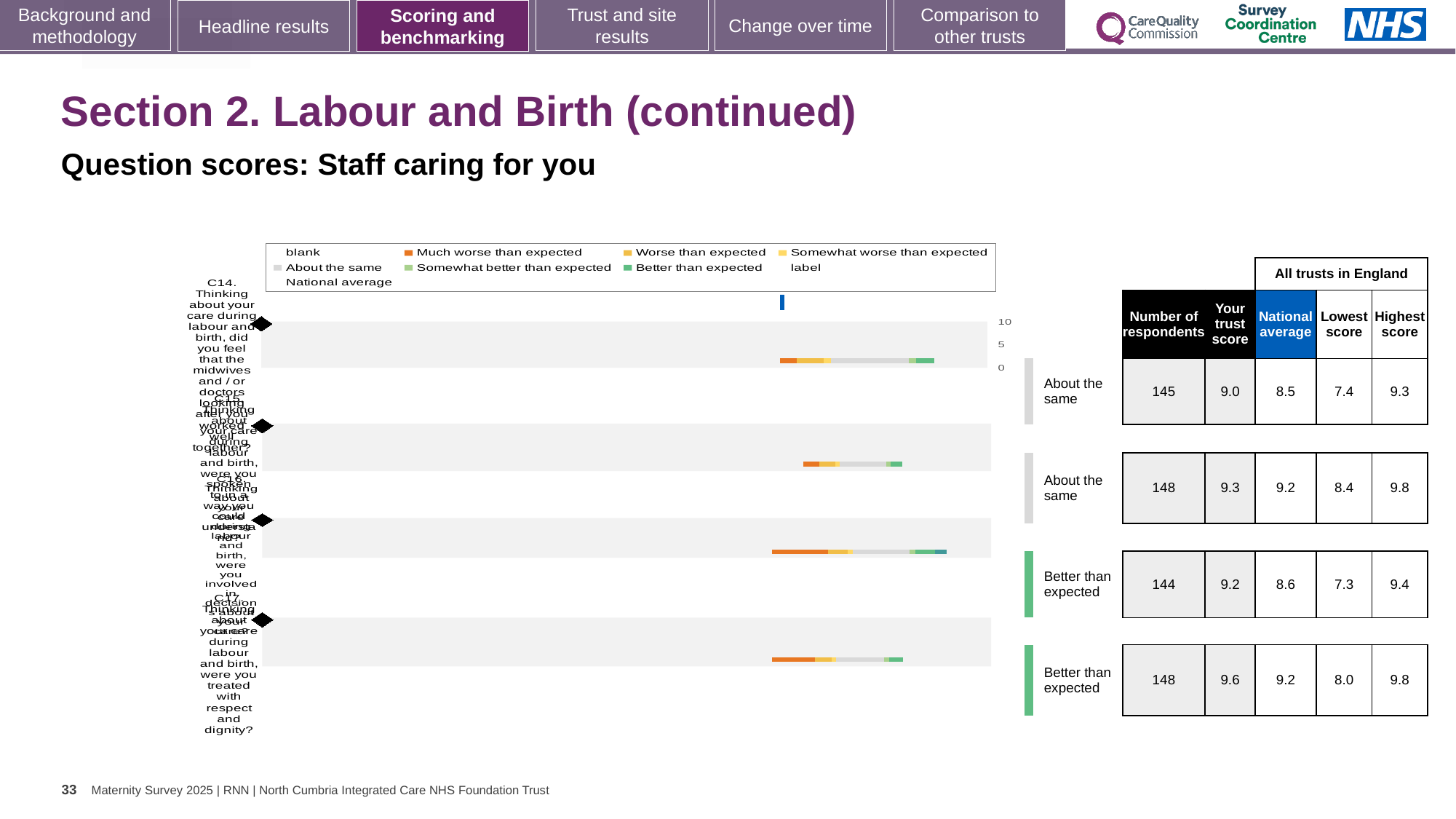
How many entries does the chart's legend list? 9 What kind of chart is shown on the slide? bar chart In the table beside the chart, for the first row (C14), which is larger: the trust score or the national average? the trust score (9.0) In the table beside the chart, how many respondents are listed for the second row? 148 In the table beside the chart, what is the difference between the trust score and the national average for the fourth row (C17)? 0.4 What is the subtitle describing the question scores shown on the slide? Question scores: Staff caring for you Which row in the table beside the chart has the highest 'Your trust score'? the fourth row (C17, treated with respect and dignity), 9.6 In the table beside the chart, what is the national average for the fourth row (C17, treated with respect and dignity)? 9.2 How many question rows (categories) does the chart show? 4 In the table beside the chart, what is the 'Your trust score' for the first row (C14, midwives and/or doctors worked well together)? 9.0 What colour does the legend use for 'Much worse than expected'? orange What benchmark category is shown for the third row of the chart? Better than expected